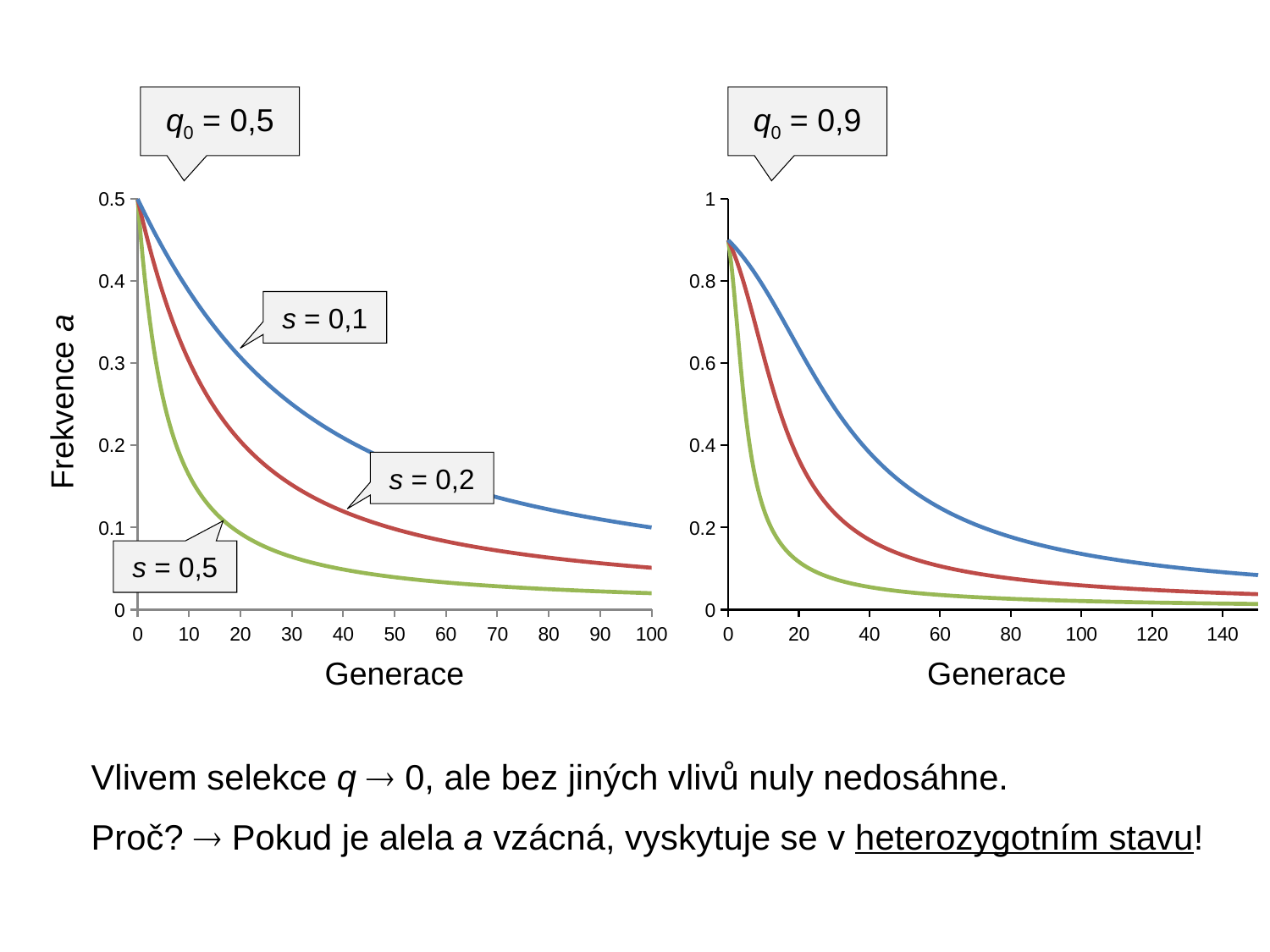
On the right chart (q0 = 0,9), is the value of the blue curve at generation 60 greater or less than 0.2? greater On the left chart (q0 = 0,5), is the value of the s = 0,5 curve at generation 20 greater or less than 0.2? less What is the label of the y axis on the left chart? Frekvence a On the left chart (q0 = 0,5), is the value of the s = 0,1 curve at generation 100 greater or less than 0.2? less What is the highest generation value labelled on the x axis of the right chart (q0 = 0,9)? 140 On the left chart (q0 = 0,5), which curve has the lowest frequency at generation 10? s = 0,5 How many curves are plotted on the left chart (q0 = 0,5)? 3 What kind of chart is the left chart (q0 = 0,5)? line chart On the left chart (q0 = 0,5), which curve is higher at generation 30: s = 0,1 or s = 0,5? s = 0,1 On the left chart (q0 = 0,5), do the curves rise or fall as the generation number increases? fall On the left chart (q0 = 0,5), what is the frequency of a at generation 0? 0.5 On the right chart (q0 = 0,9), what is the starting frequency of a at generation 0? 0,9